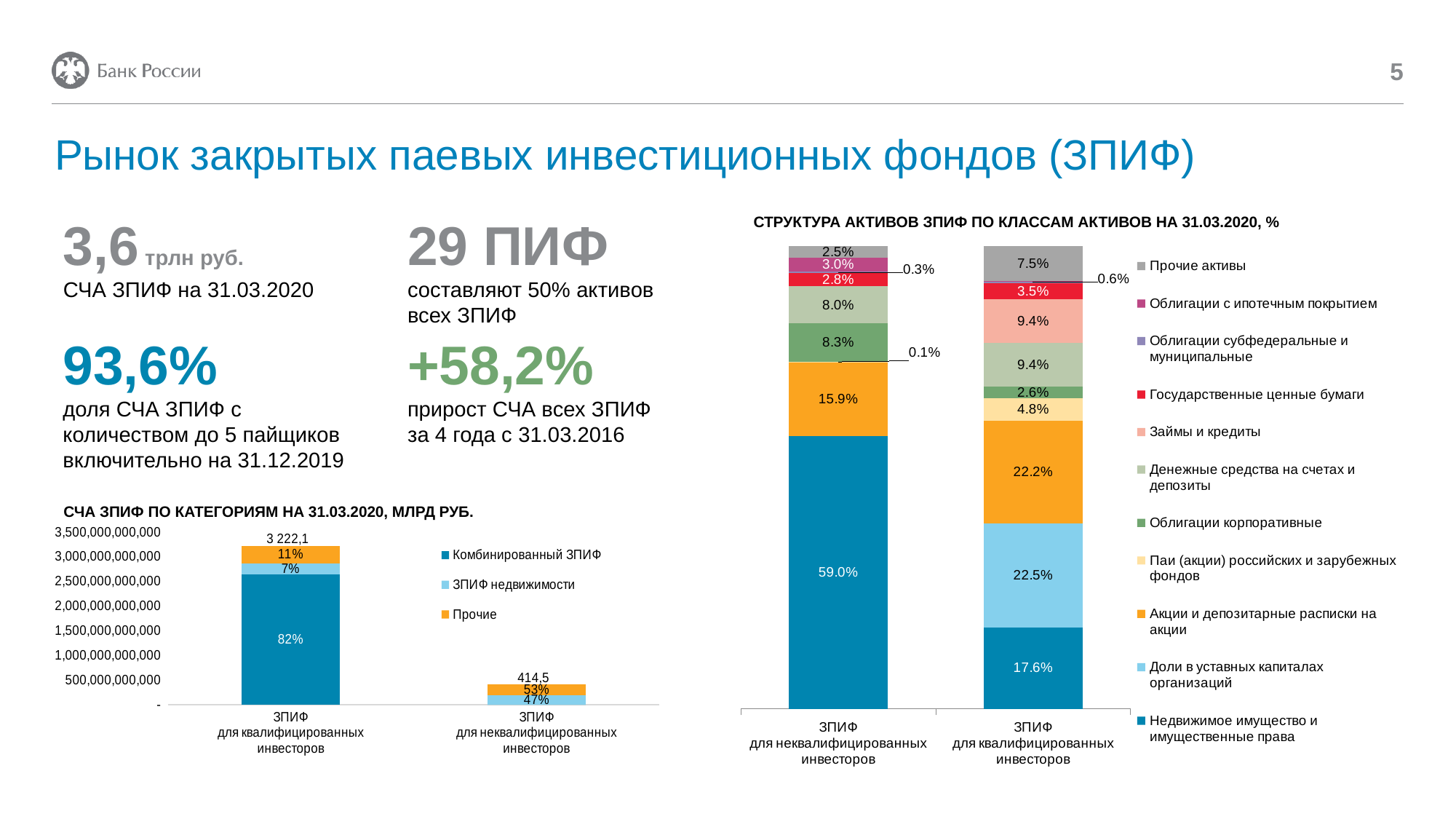
In the chart 'СЧА ЗПИФ ПО КАТЕГОРИЯМ НА 31.03.2020, МЛРД РУБ.', what is the total value for ЗПИФ для неквалифицированных инвесторов? 414,5 In the chart 'СТРУКТУРА АКТИВОВ ЗПИФ ПО КЛАССАМ АКТИВОВ НА 31.03.2020, %', what is the share of Доли в уставных капиталах организаций for ЗПИФ для квалифицированных инвесторов? 22.5% In the chart 'СТРУКТУРА АКТИВОВ ЗПИФ ПО КЛАССАМ АКТИВОВ НА 31.03.2020, %', what is the share of Недвижимое имущество и имущественные права for ЗПИФ для неквалифицированных инвесторов? 59.0% In the chart 'СТРУКТУРА АКТИВОВ ЗПИФ ПО КЛАССАМ АКТИВОВ НА 31.03.2020, %', how many series does the legend list? 11 In the chart 'СТРУКТУРА АКТИВОВ ЗПИФ ПО КЛАССАМ АКТИВОВ НА 31.03.2020, %', what is the share of Прочие активы for ЗПИФ для квалифицированных инвесторов? 7.5% In the chart 'СЧА ЗПИФ ПО КАТЕГОРИЯМ НА 31.03.2020, МЛРД РУБ.', what share does Комбинированный ЗПИФ make up of ЗПИФ для квалифицированных инвесторов? 82% In the chart 'СЧА ЗПИФ ПО КАТЕГОРИЯМ НА 31.03.2020, МЛРД РУБ.', what share does Прочие make up of ЗПИФ для неквалифицированных инвесторов? 53% What type of chart is 'СТРУКТУРА АКТИВОВ ЗПИФ ПО КЛАССАМ АКТИВОВ НА 31.03.2020, %'? Stacked bar chart In the chart 'СЧА ЗПИФ ПО КАТЕГОРИЯМ НА 31.03.2020, МЛРД РУБ.', how many series does the legend list? 3 In the chart 'СЧА ЗПИФ ПО КАТЕГОРИЯМ НА 31.03.2020, МЛРД РУБ.', what is the total value for ЗПИФ для квалифицированных инвесторов? 3 222,1 In the chart 'СЧА ЗПИФ ПО КАТЕГОРИЯМ НА 31.03.2020, МЛРД РУБ.', which category has the larger total, ЗПИФ для квалифицированных инвесторов or ЗПИФ для неквалифицированных инвесторов? ЗПИФ для квалифицированных инвесторов In the chart 'СЧА ЗПИФ ПО КАТЕГОРИЯМ НА 31.03.2020, МЛРД РУБ.', what is the difference between the totals of the two categories? 2 807,6